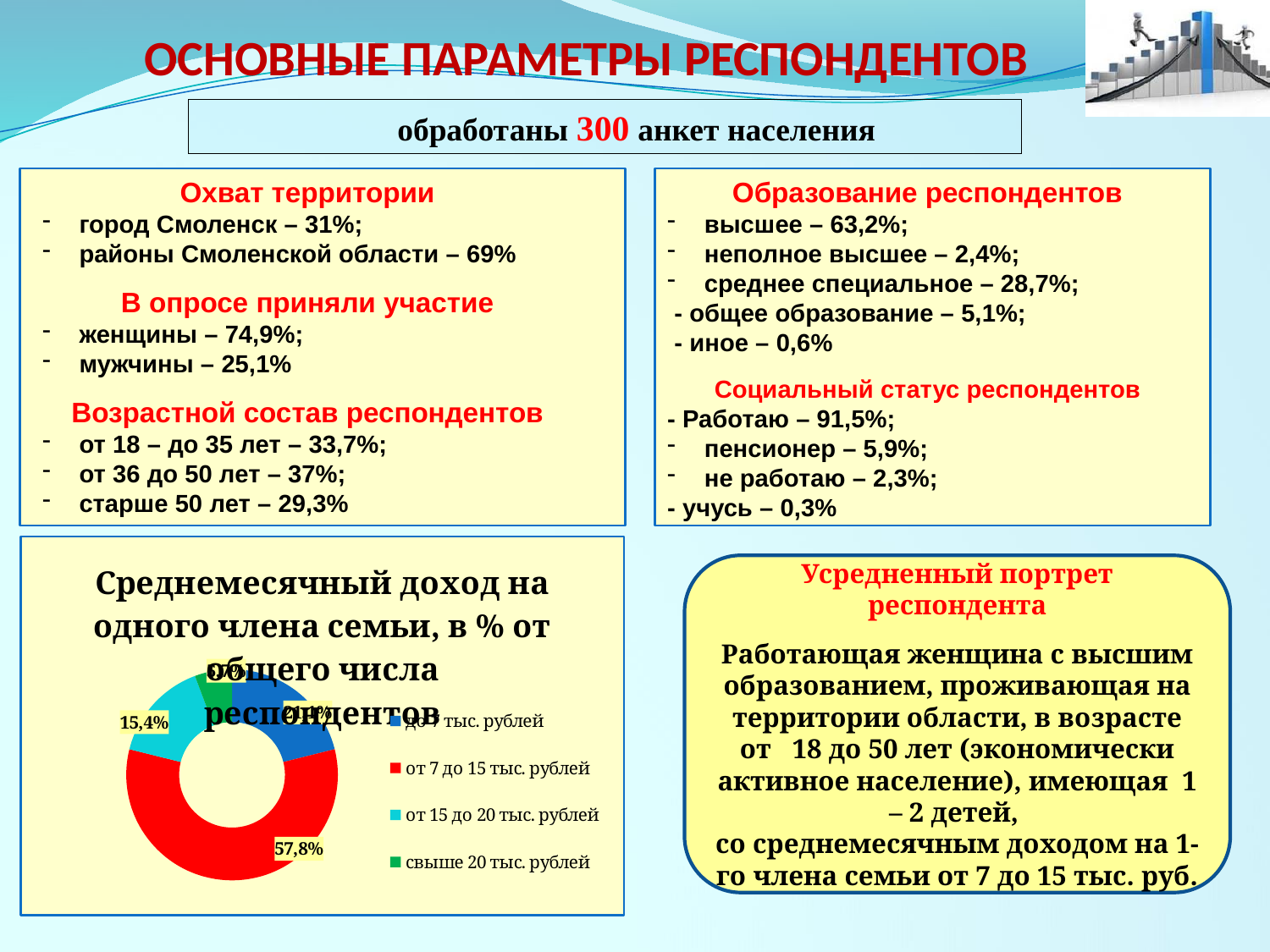
What share of respondents have an average monthly income per family member of от 7 до 15 тыс. рублей? 57,8% How many categories does the legend of the doughnut chart list? 4 What is the difference between the share for от 7 до 15 тыс. рублей and the share for от 15 до 20 тыс. рублей? 42,4% What share of respondents have an average monthly income per family member of от 15 до 20 тыс. рублей? 15,4% Which legend entry is shown in green in the doughnut chart? свыше 20 тыс. рублей What kind of chart is shown on the slide? doughnut (pie) chart Which income category has the largest share in the doughnut chart? от 7 до 15 тыс. рублей Which is larger: the share for от 7 до 15 тыс. рублей or the share for от 15 до 20 тыс. рублей? от 7 до 15 тыс. рублей Which colour represents the category от 7 до 15 тыс. рублей in the doughnut chart? red